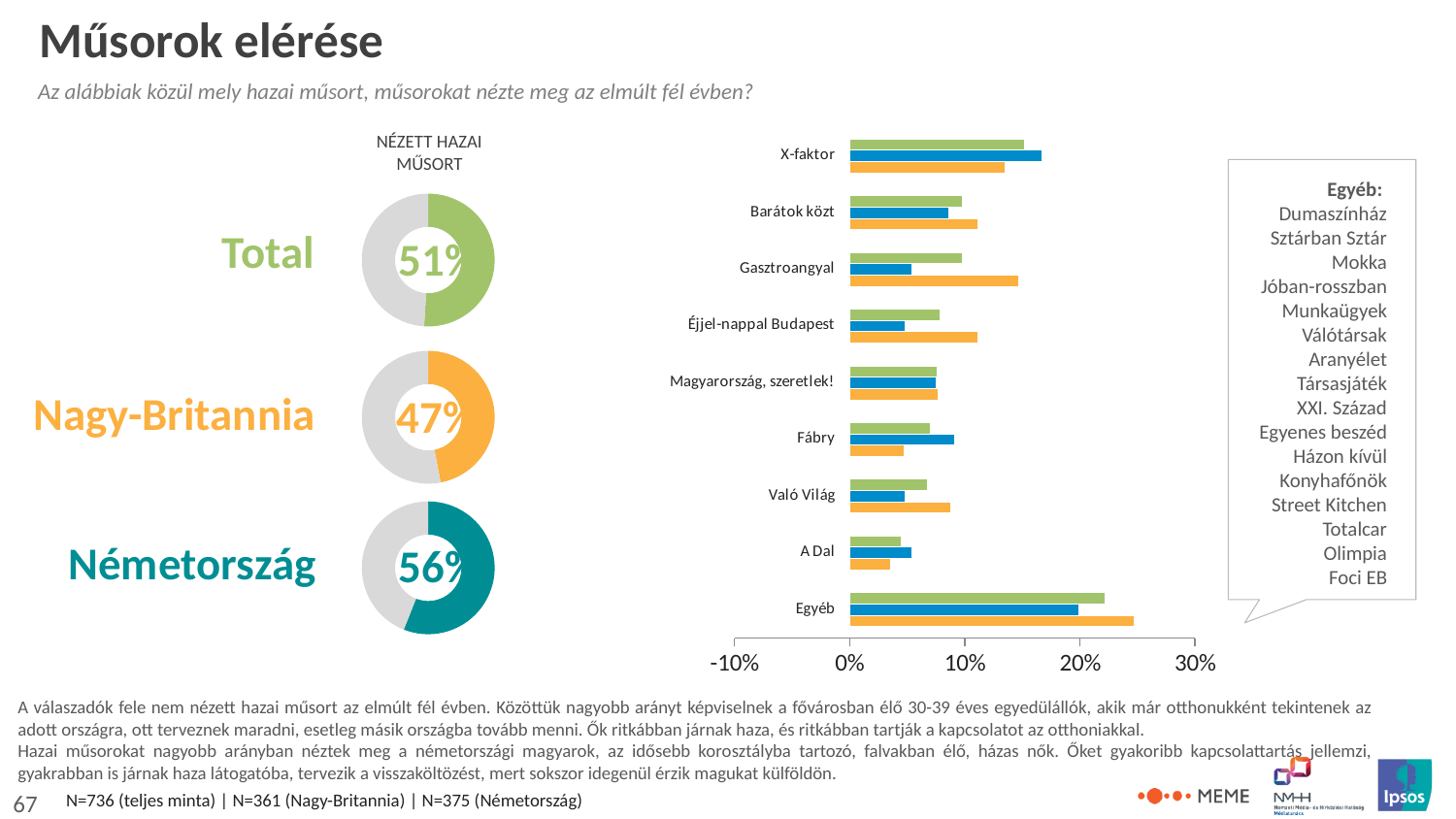
In the donut charts on the left, what is the difference in percentage points between Németország and Nagy-Britannia? 9 In the bar chart on the right, is the orange bar for Egyéb greater or less than 20%? greater In the donut charts on the left, what percentage is shown for Total? 51% In the donut charts on the left, what percentage is shown for Németország? 56% In the bar chart on the right, which category has the longest bars overall? Egyéb In the bar chart on the right, is the green bar for A Dal greater or less than 10%? less In the donut charts on the left, which is larger: the value for Total or the value for Nagy-Britannia? Total What kind of chart is the chart on the right showing the programmes (X-faktor, Barátok közt, etc.)? bar chart How many programme categories are listed on the bar chart on the right? 9 Among the three donut charts on the left, which group has the highest percentage? Németország In the donut charts on the left, what percentage is shown for Nagy-Britannia? 47% Among the three donut charts on the left, which group has the lowest percentage? Nagy-Britannia